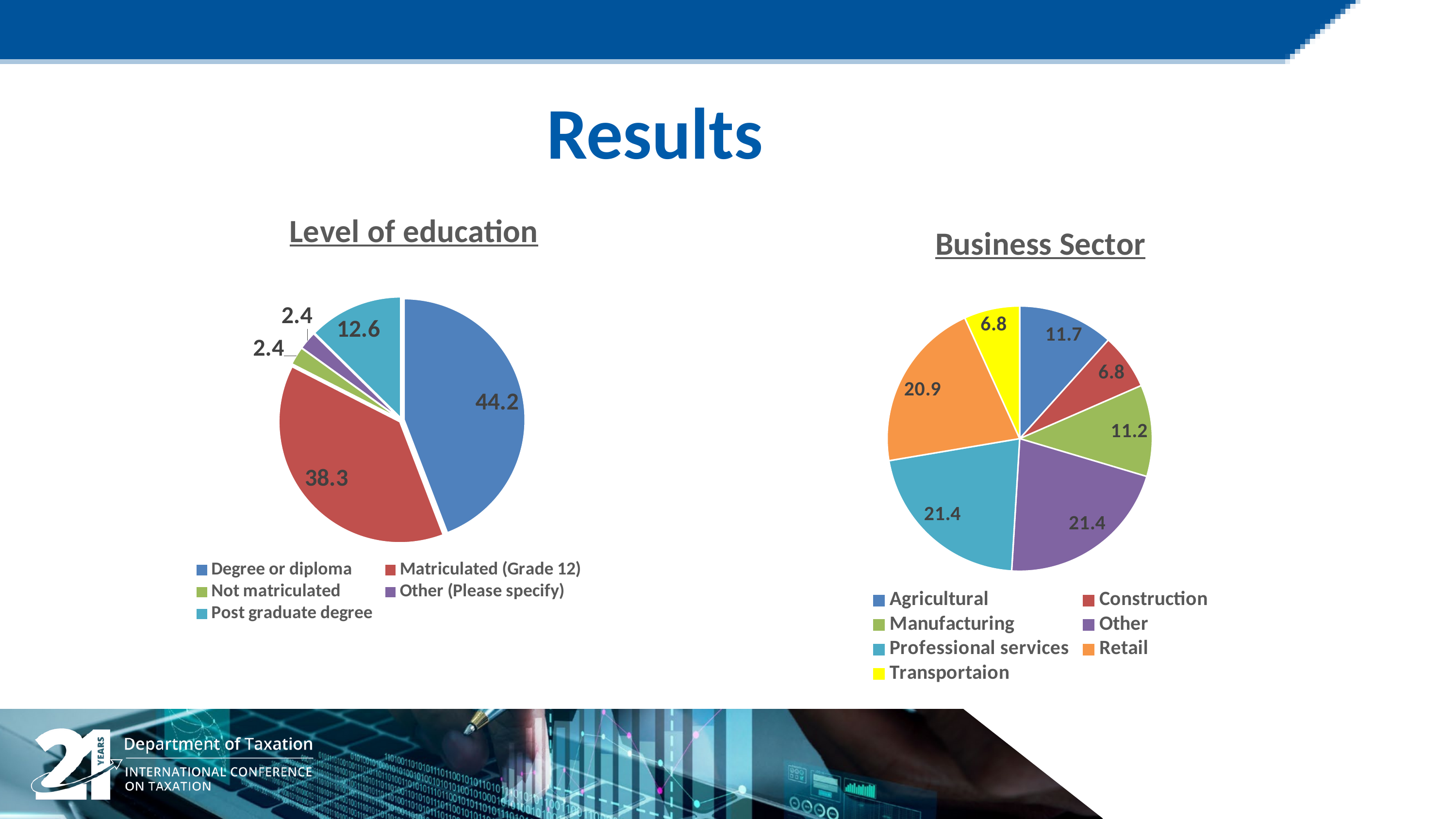
In the Business Sector chart, what is the value for Manufacturing? 11.2 What type of chart is the Business Sector chart? Pie chart In the Level of education chart, what is the value for Degree or diploma? 44.2 In the Business Sector chart, what is the value for Retail? 20.9 In the Business Sector chart, which is larger, Retail or Construction? Retail In the Business Sector chart, how many sectors does the legend list? 7 In the Level of education chart, what is the value for Matriculated (Grade 12)? 38.3 In the Level of education chart, what is the difference between Degree or diploma and Matriculated (Grade 12)? 5.9 In the Level of education chart, how many categories does the legend list? 5 In the Business Sector chart, what is the value for Agricultural? 11.7 In the Level of education chart, which category has the largest share? Degree or diploma In the Level of education chart, what is the value for Post graduate degree? 12.6